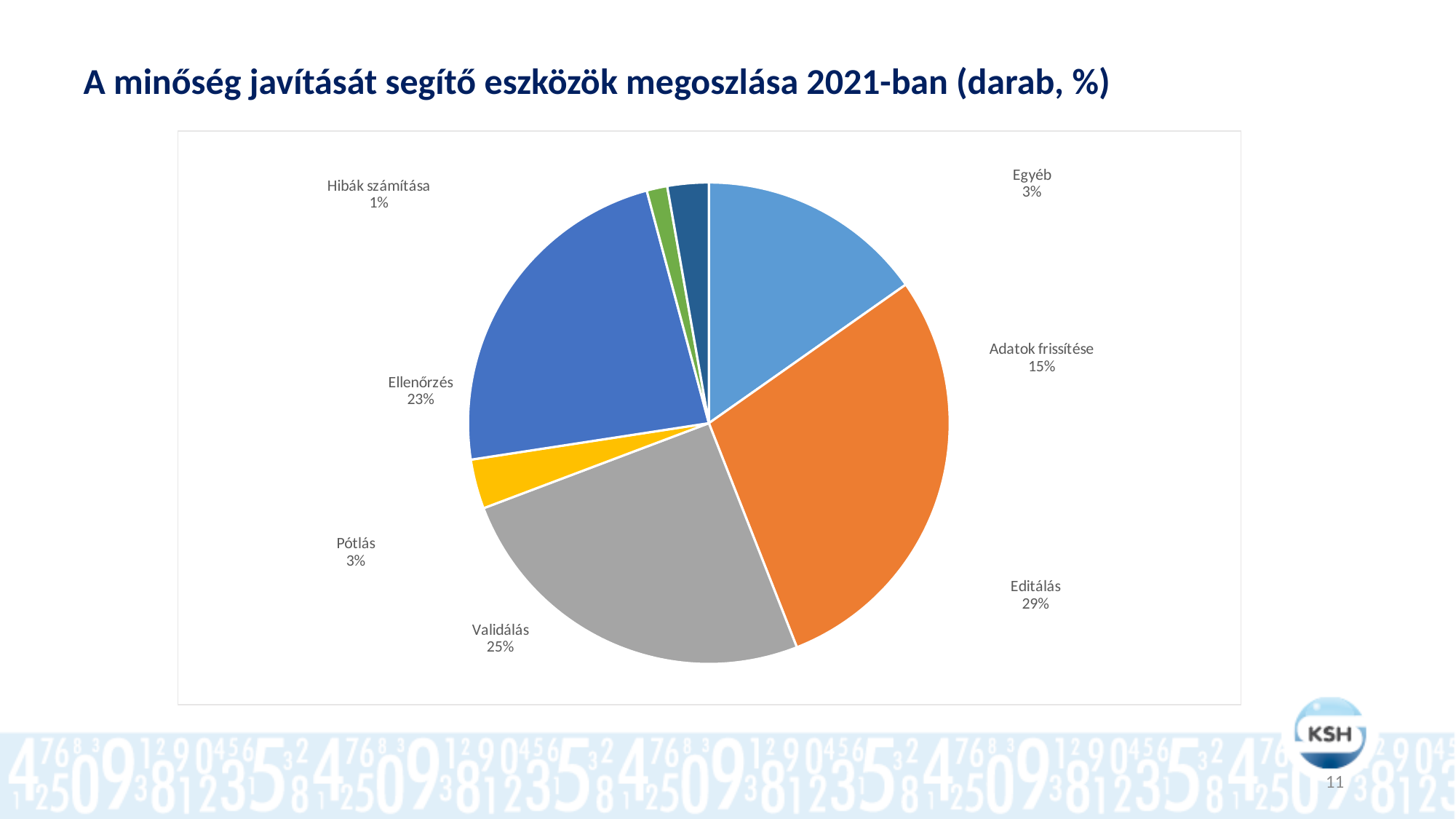
What share of the pie does Editálás have? 29% What is the title of the slide? A minőség javítását segítő eszközök megoszlása 2021-ban (darab, %) Which is larger, the share for Ellenőrzés or the share for Adatok frissítése? Ellenőrzés Which category has the smallest slice of the pie? Hibák számítása What share of the pie does Validálás have? 25% What is the value shown for Hibák számítása? 1% What is the value shown for Adatok frissítése? 15% How many categories are shown in the pie chart? 7 What is the value shown for Ellenőrzés? 23% What is the difference in percentage points between Editálás and Validálás? 4 Which category has the largest slice of the pie? Editálás What kind of chart is shown on the slide? Pie chart